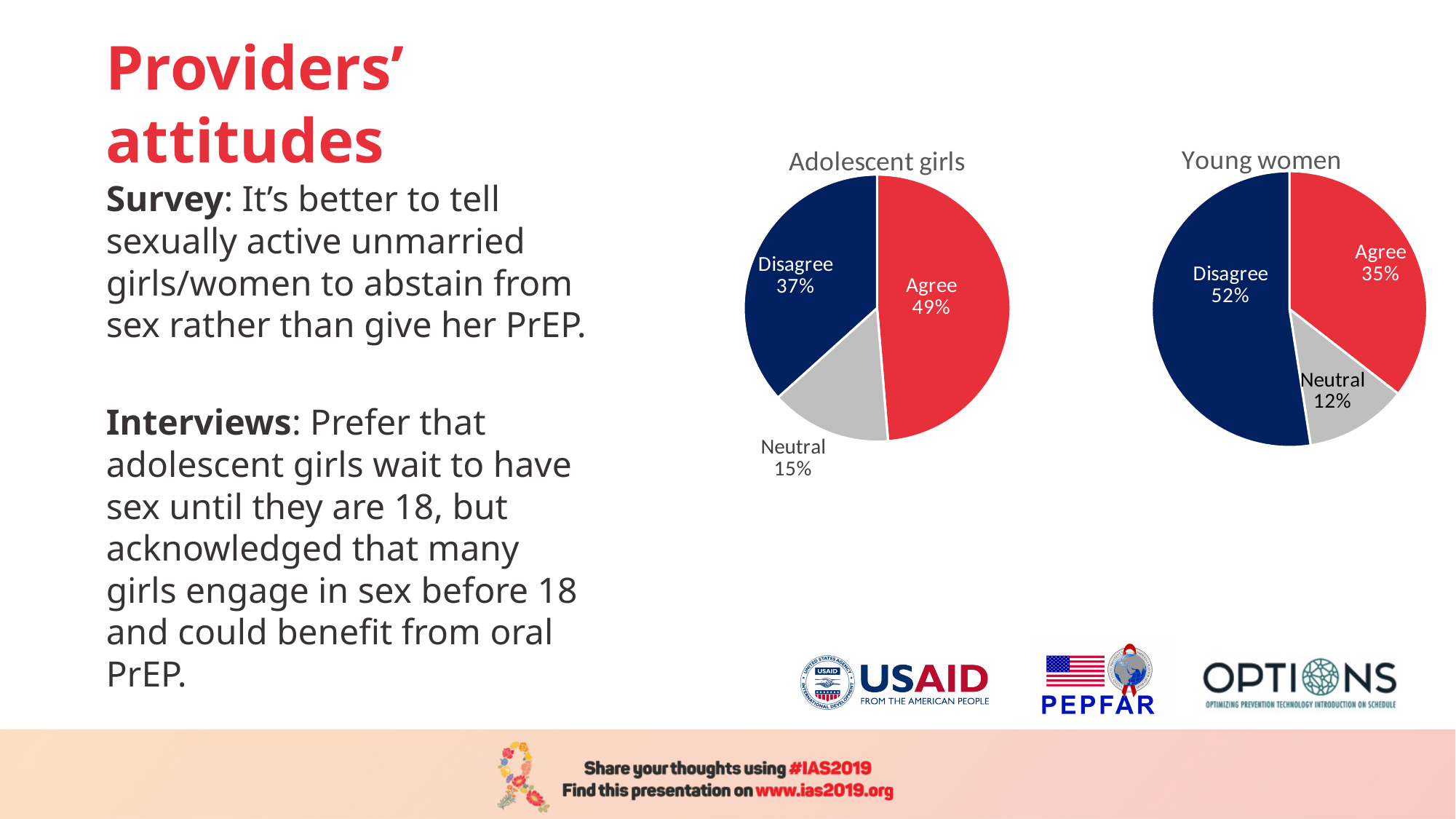
In the 'Young women' pie chart, which response has the smallest share? Neutral Is the Agree share larger in the 'Adolescent girls' chart or the 'Young women' chart? Adolescent girls In the 'Young women' pie chart, what is the difference between the Disagree and Agree shares? 17% In the 'Adolescent girls' pie chart, what is the difference between the Agree and Disagree shares? 12% In the 'Young women' pie chart, what is the share for Agree? 35% What colour is the Disagree slice in the 'Adolescent girls' pie chart? Dark blue How many slices does the 'Young women' pie chart have? 3 In the 'Young women' pie chart, what percentage of providers disagree? 52% In the 'Adolescent girls' pie chart, which response has the largest share? Agree What type of chart is used to show providers' attitudes for adolescent girls? Pie chart In the 'Adolescent girls' pie chart, what is the share for Neutral? 15% In the 'Adolescent girls' pie chart, what percentage of providers agree? 49%